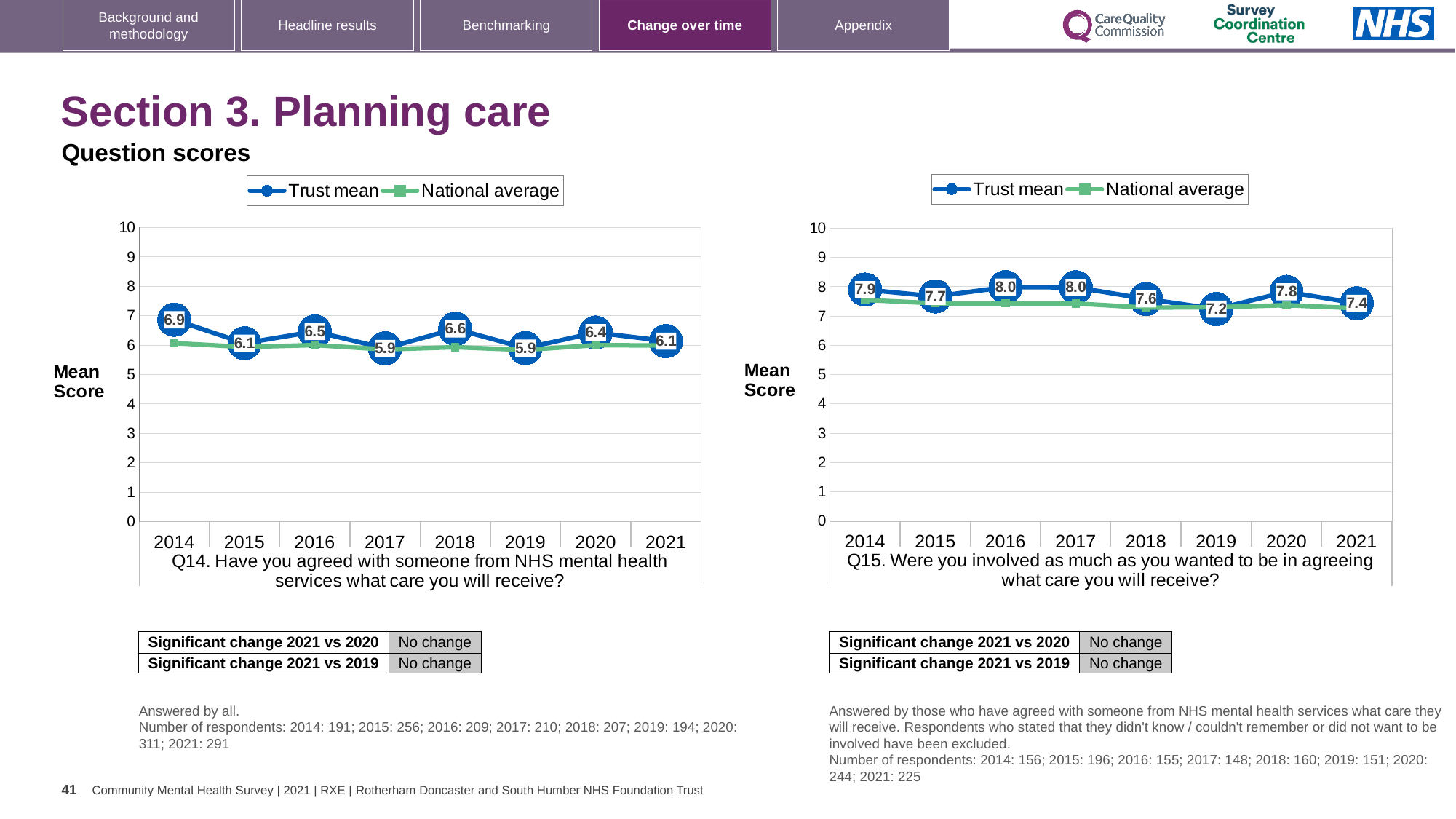
How many series does the legend of the Q15 chart on the right list? 2 In the Q15 chart on the right, what is the Trust mean for 2021? 7.4 In the Q15 chart on the right, which year has the lowest Trust mean? 2019 In the Q14 chart on the left, what is the difference between the Trust mean in 2014 and in 2021? 0.8 In the Q15 chart on the right, what is the Trust mean for 2019? 7.2 In the Q14 chart on the left, what is the Trust mean for 2021? 6.1 How many years are shown on the x axis of the Q14 chart on the left? 8 In the Q15 chart on the right, is the Trust mean higher in 2020 or in 2021? 2020 In the Q14 chart on the left, which year has the highest Trust mean? 2014 In the Q15 chart on the right, is the National average for 2014 greater or less than 7? greater In the Q14 chart on the left, what is the Trust mean for 2014? 6.9 What type of chart is the Q14 chart on the left? Line chart